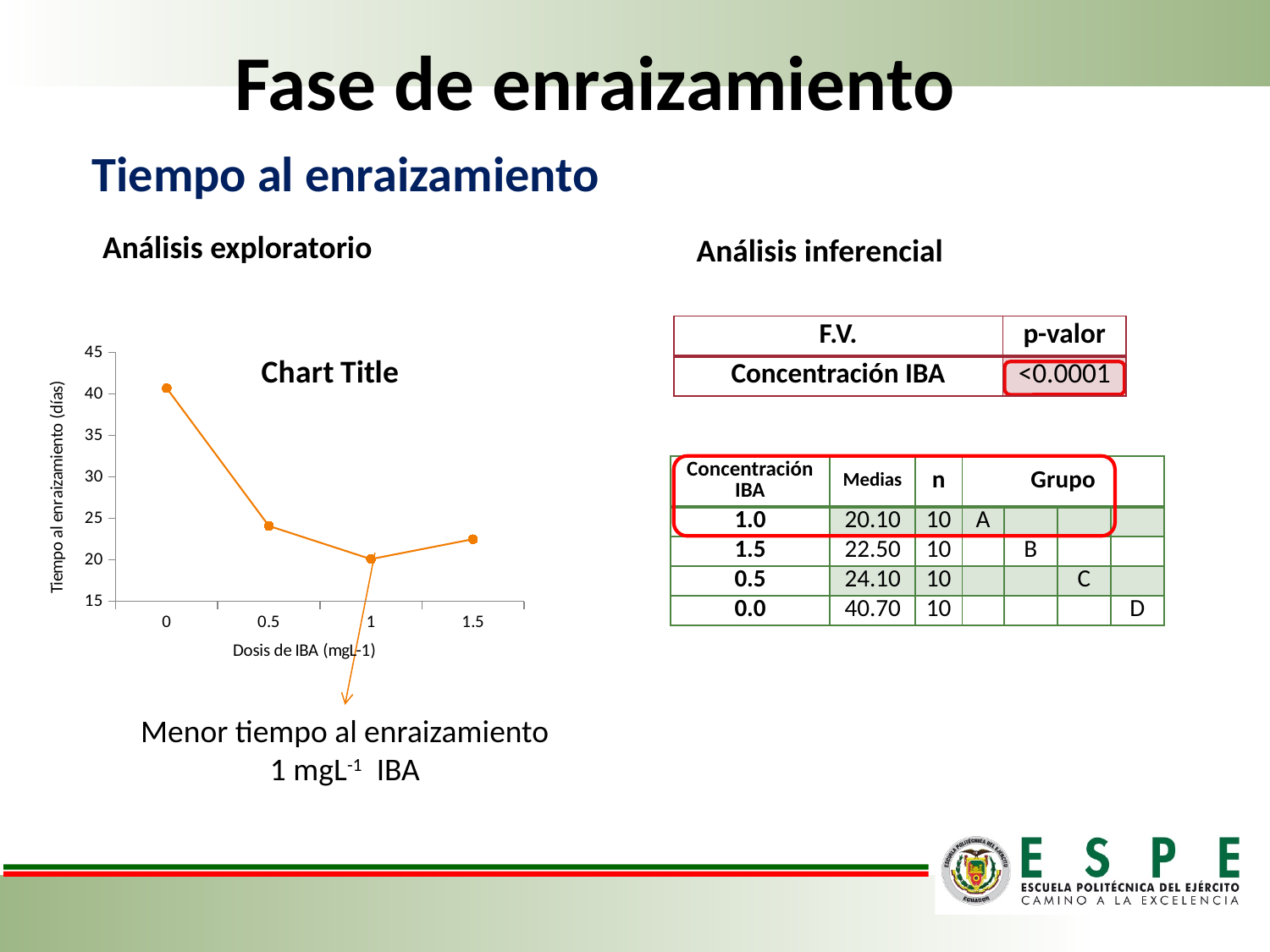
On the line chart, is the value at dose 0.5 greater or less than 30? less On the line chart, is the value at dose 0 greater or less than 35? greater At which IBA dose is the rooting time lowest on the line chart? 1 Does the rooting time rise or fall as the IBA dose goes from 0 to 1 on the line chart? fall At which IBA dose is the rooting time (Tiempo al enraizamiento) highest on the line chart? 0 What is the label of the y axis on the line chart? Tiempo al enraizamiento (días) What kind of chart is shown under 'Análisis exploratorio'? line chart On the line chart, is the value at dose 1.5 greater or less than 25? less What is the title shown on the line chart? Chart Title How many data points are plotted on the line chart? 4 On the line chart, which has the larger rooting time: dose 0 or dose 1? 0